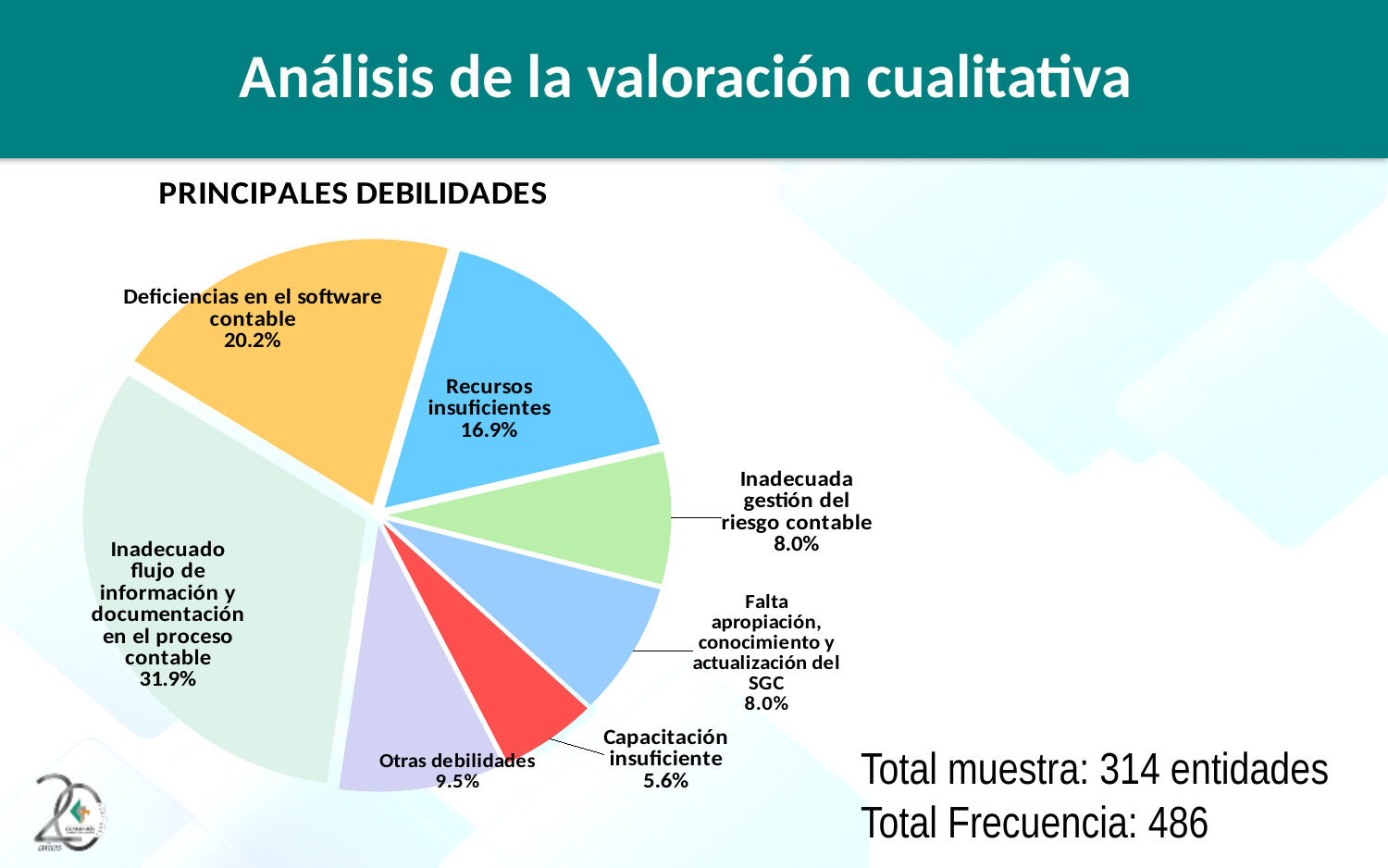
Which category has the largest slice of the pie? Inadecuado flujo de información y documentación en el proceso contable What is the title of the chart? PRINCIPALES DEBILIDADES What share of the pie is 'Capacitación insuficiente'? 5.6% Which is larger, 'Recursos insuficientes' or 'Otras debilidades'? Recursos insuficientes What share of the pie is 'Recursos insuficientes'? 16.9% Which category has the smallest slice of the pie? Capacitación insuficiente What share of the pie is 'Inadecuada gestión del riesgo contable'? 8.0% How many slices does the pie chart have? 7 What kind of chart is shown on the slide? Pie chart What is the difference in percentage points between 'Inadecuado flujo de información y documentación en el proceso contable' and 'Deficiencias en el software contable'? 11.7